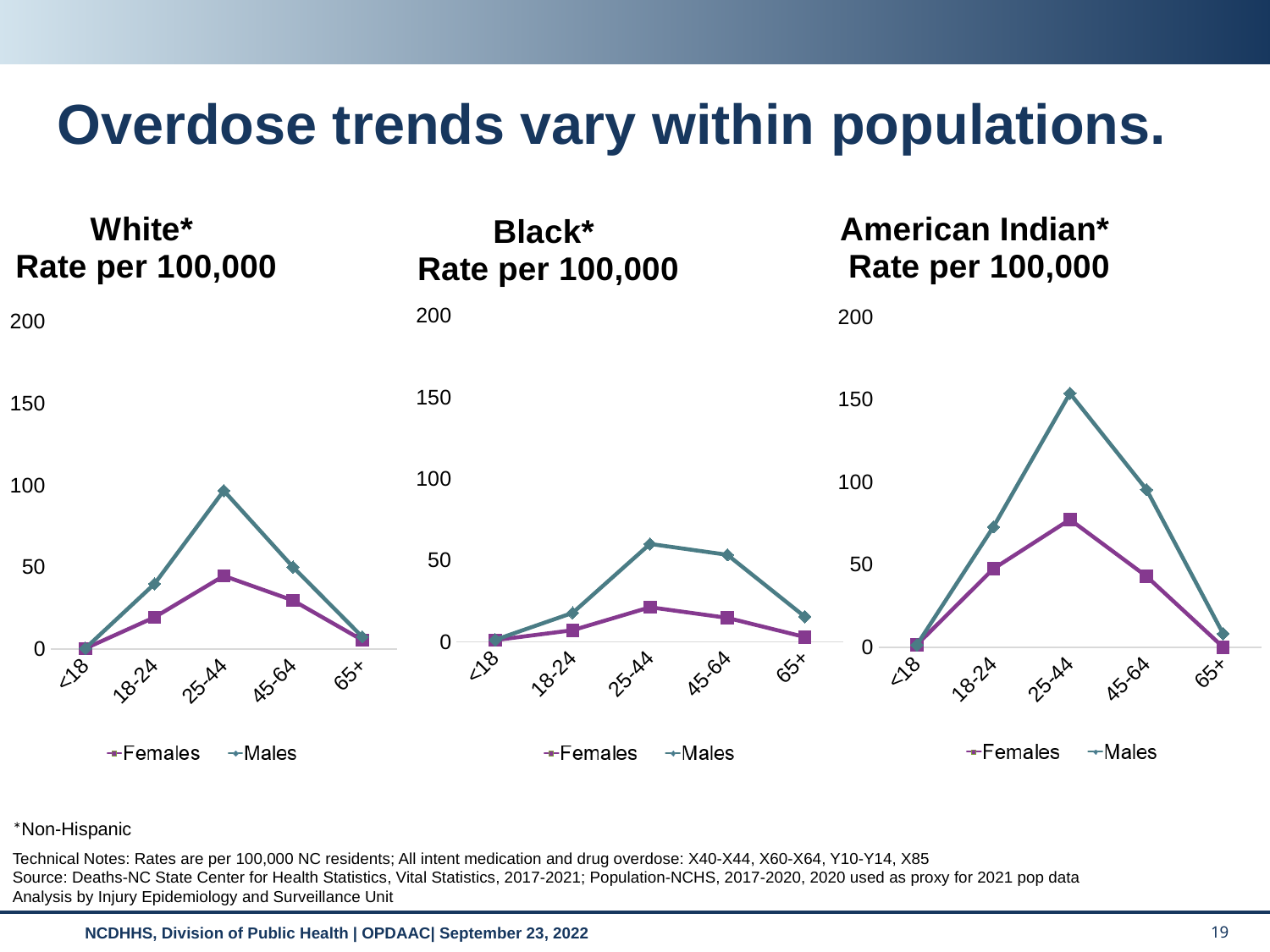
What kind of chart is the White* chart? line chart How many age groups are shown on the x axis of the Black* chart? 5 In the American Indian* chart, do the Males values rise or fall from 25-44 to 65+? fall In the American Indian* chart, which age group has the highest rate for Males? 25-44 In the Black* chart, is the Females value for 25-44 greater or less than 50? less What are the two series named in the legend of the White* chart? Females and Males In the Black* chart, which age group has the lowest rate for Males? <18 In the Black* chart, which is larger for the 25-44 age group, Males or Females? Males In the White* chart, which age group has the highest rate for Females? 25-44 In the White* chart, is the Males value for 25-44 greater or less than 50? greater In the American Indian* chart, is the Males value for 25-44 greater or less than 100? greater How many series does the legend of the American Indian* chart list? 2